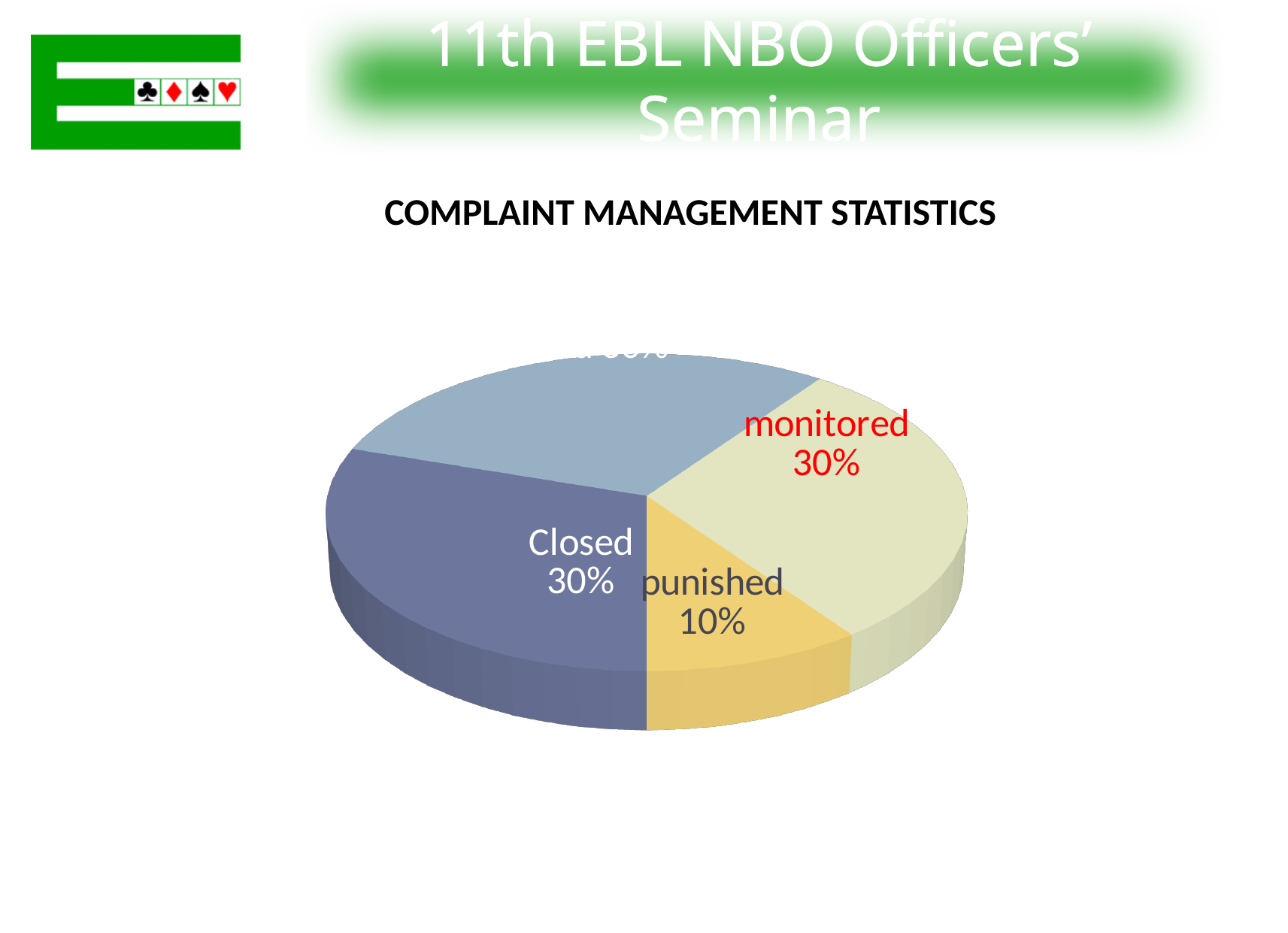
What percentage of the pie is labelled "monitored"? 30% What kind of chart is shown on the slide? Pie chart What percentage of the pie is labelled "Closed"? 30% What colour is the "punished" slice of the pie? Yellow What is the title shown above the pie chart? COMPLAINT MANAGEMENT STATISTICS By how many percentage points does the "Closed" share exceed the "punished" share? 20 percentage points Which is larger, the "monitored" slice or the "punished" slice? monitored How many slices does the pie chart have? 4 Which is larger, the "Closed" slice or the "punished" slice? Closed Which labelled slice has the smallest share of the pie? punished What percentage of the pie is labelled "punished"? 10%